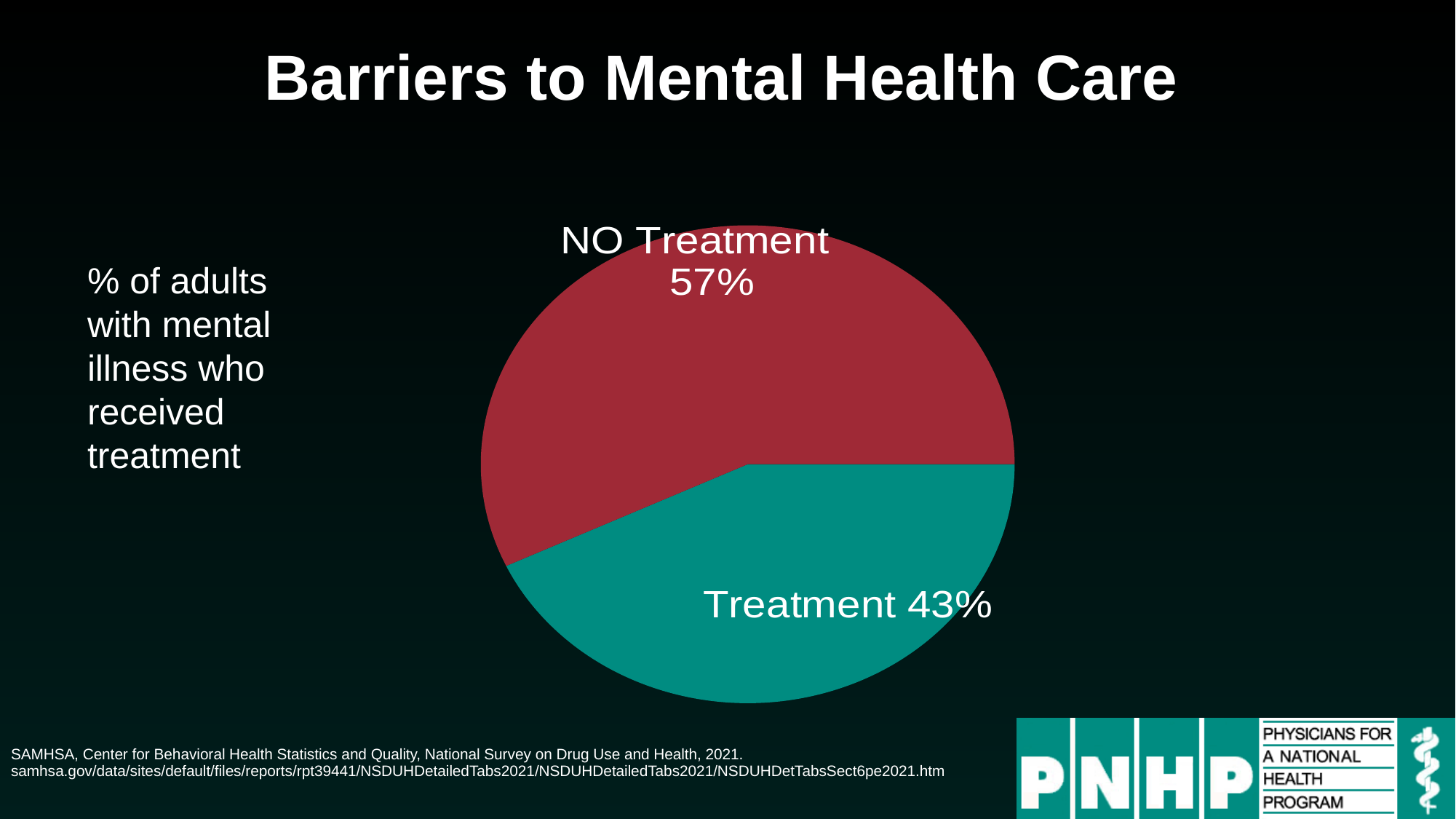
What share of the pie does the Treatment slice represent? 43% What is the title of the slide containing the pie chart? Barriers to Mental Health Care What percentage of adults with mental illness received NO Treatment? 57% What is the difference in percentage points between the NO Treatment and Treatment slices? 14 What percentage of adults with mental illness received Treatment? 43% Which slice of the pie is the largest? NO Treatment Which slice of the pie is the smallest? Treatment Which is larger, the NO Treatment slice or the Treatment slice? NO Treatment What colour is the NO Treatment slice of the pie chart? red How many slices does the pie chart have? 2 What kind of chart is shown on the slide? pie chart